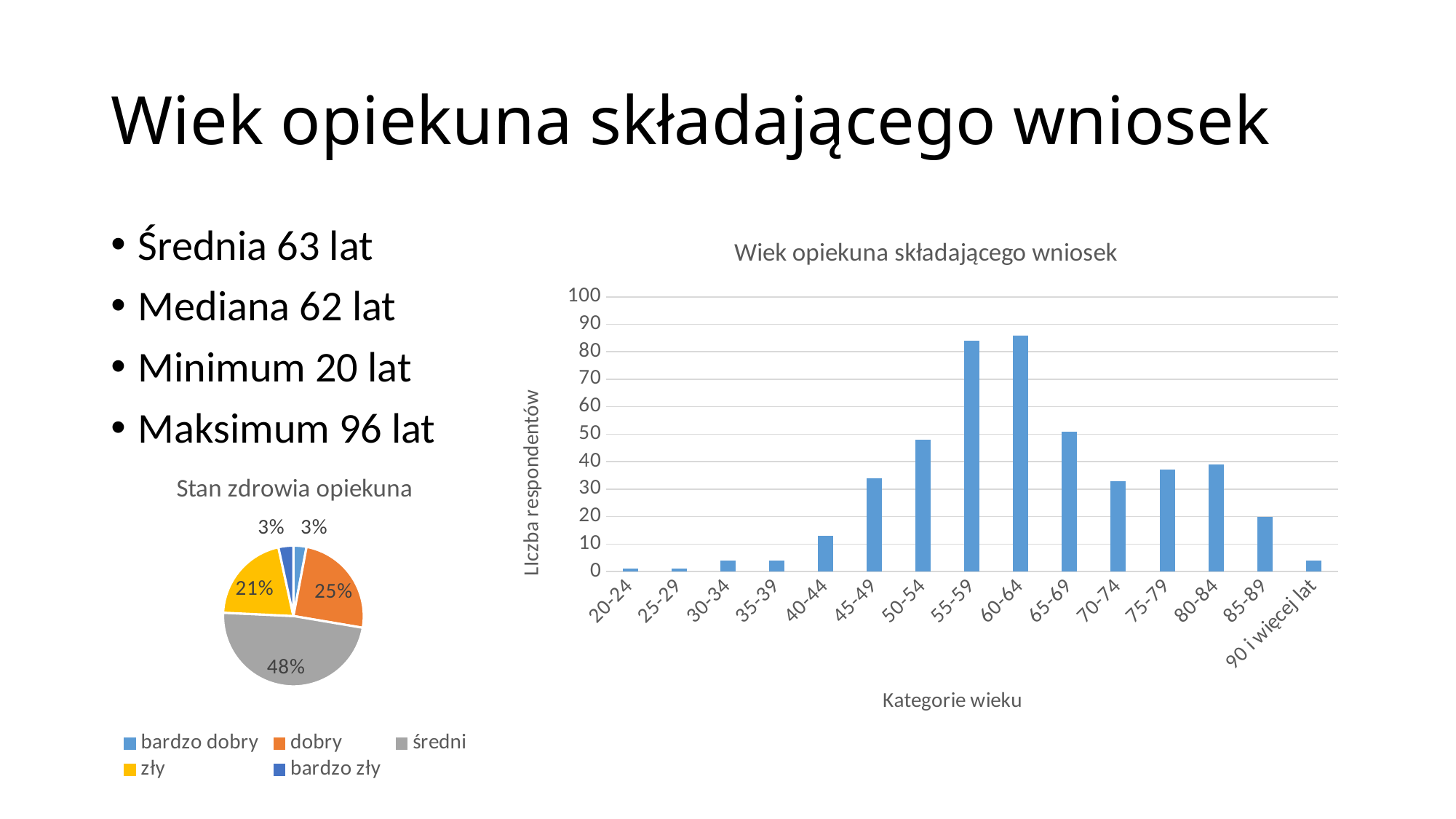
In the bar chart 'Wiek opiekuna składającego wniosek', which is larger, the value for 45-49 or the value for 50-54? 50-54 In the pie chart 'Stan zdrowia opiekuna', what share is labelled for 'dobry'? 25% How many categories does the legend of the pie chart 'Stan zdrowia opiekuna' list? 5 What kind of chart is 'Wiek opiekuna składającego wniosek'? bar chart What is the y-axis title of the bar chart 'Wiek opiekuna składającego wniosek'? Liczba respondentów In the pie chart 'Stan zdrowia opiekuna', what is the difference between the shares for 'średni' and 'dobry'? 23% In the bar chart 'Wiek opiekuna składającego wniosek', is the value for 40-44 greater or less than 10? greater In the pie chart 'Stan zdrowia opiekuna', which category has the largest slice? średni In the pie chart 'Stan zdrowia opiekuna', what share is labelled for 'zły'? 21% How many age categories are shown on the x axis of the bar chart 'Wiek opiekuna składającego wniosek'? 15 In the bar chart 'Wiek opiekuna składającego wniosek', is the value for 45-49 greater or less than 30? greater In the pie chart 'Stan zdrowia opiekuna', what share is labelled for 'średni'? 48%